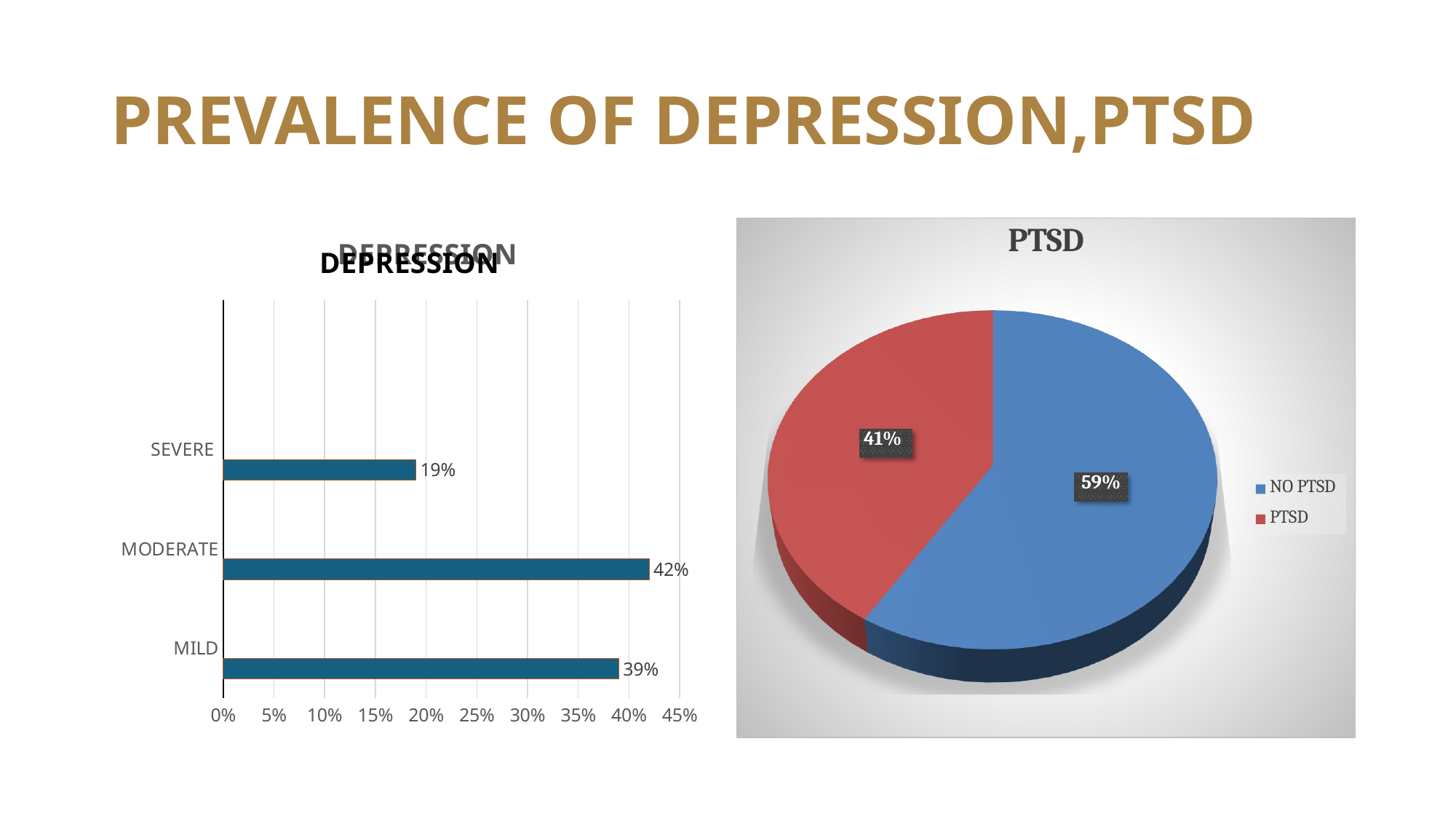
What kind of chart is the PTSD chart? Pie chart In the DEPRESSION chart, which category has the lowest value? SEVERE In the DEPRESSION chart, what is the difference between the MODERATE and SEVERE values? 23% In the DEPRESSION chart, which category has the highest value? MODERATE In the DEPRESSION chart, what is the value for SEVERE? 19% In the DEPRESSION chart, what is the value for MODERATE? 42% In the PTSD chart, what share of the pie is PTSD? 41% In the DEPRESSION chart, which is larger, MILD or SEVERE? MILD What kind of chart is the DEPRESSION chart? Bar chart In the DEPRESSION chart, what is the value for MILD? 39% In the PTSD chart, what share of the pie is NO PTSD? 59% How many categories are shown in the DEPRESSION chart? 3